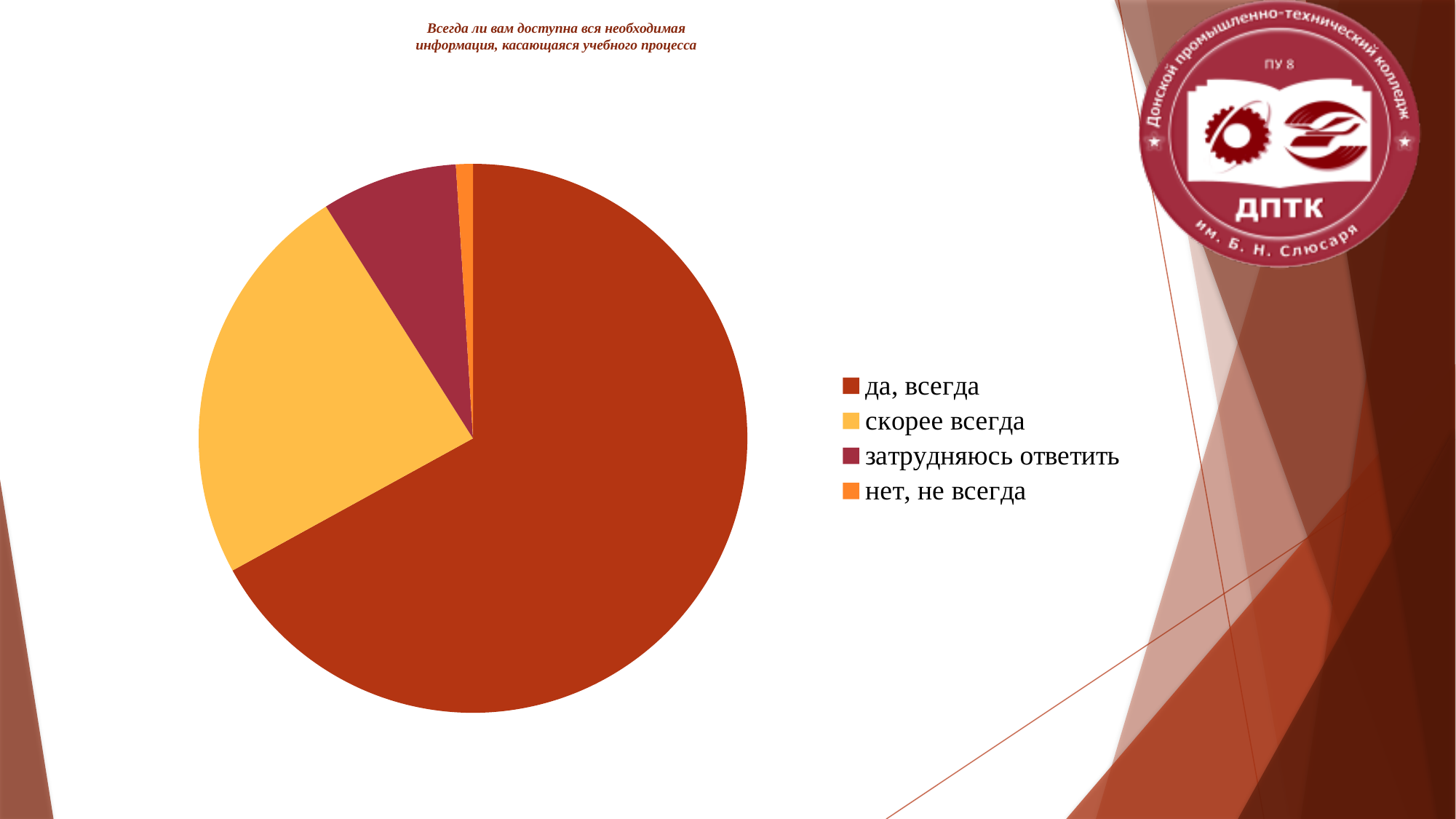
Which category has the smallest slice of the pie chart? нет, не всегда Which category is shown in yellow in the pie chart? скорее всегда What is the title of the chart on the slide? Всегда ли вам доступна вся необходимая информация, касающаяся учебного процесса Which category is the second largest slice of the pie chart? скорее всегда What kind of chart is shown on the slide? pie chart How many categories does the pie chart's legend list? 4 Which slice is larger: "да, всегда" or "скорее всегда"? да, всегда Which slice is larger: "скорее всегда" or "затрудняюсь ответить"? скорее всегда Which slice is larger: "затрудняюсь ответить" or "нет, не всегда"? затрудняюсь ответить Which category has the largest slice of the pie chart? да, всегда